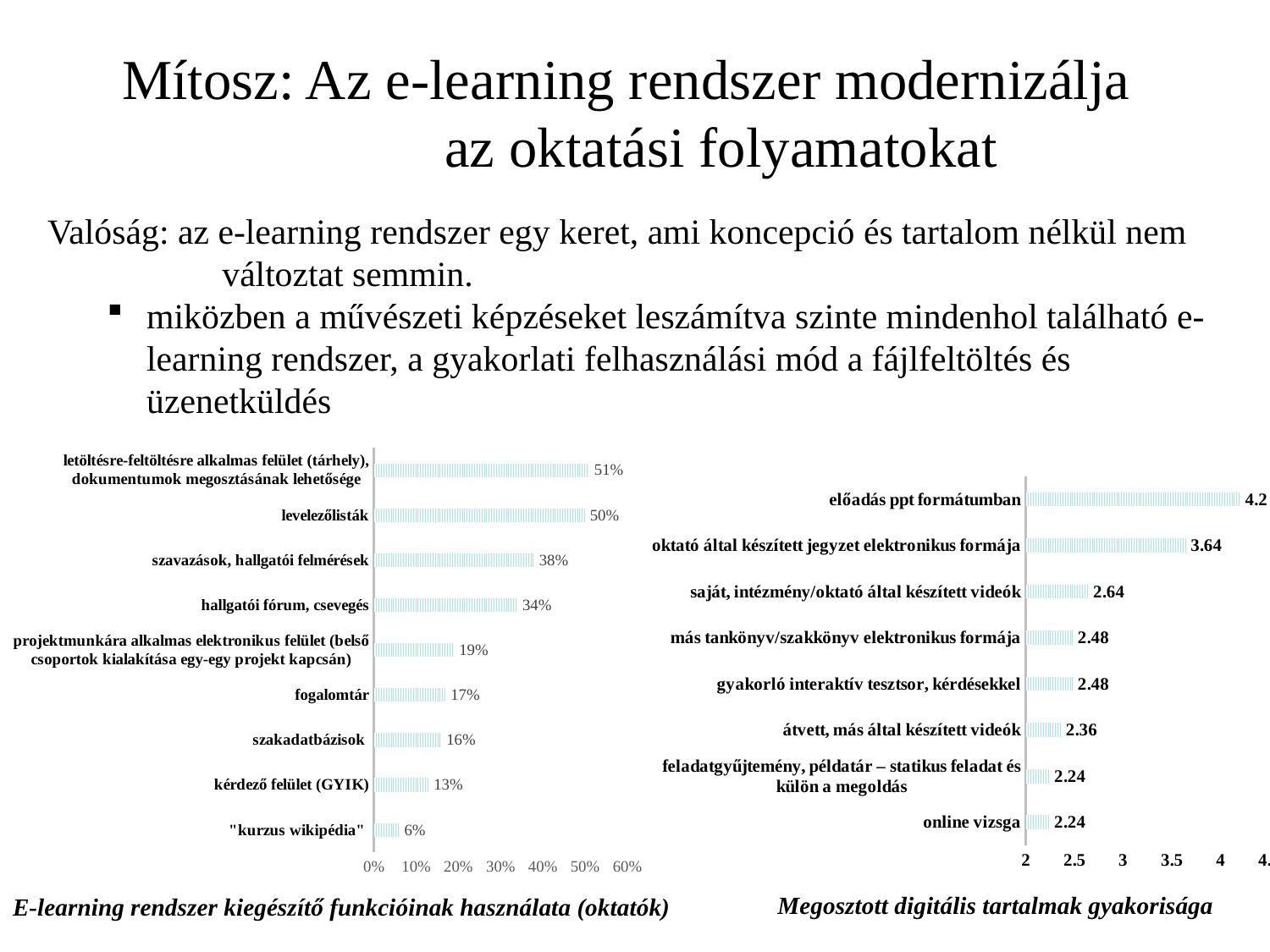
In the right chart (Megosztott digitális tartalmak gyakorisága), what is the value for "átvett, más által készített videók"? 2.36 In the right chart (Megosztott digitális tartalmak gyakorisága), what is the value for "előadás ppt formátumban"? 4.2 In the left chart (E-learning rendszer kiegészítő funkcióinak használata), what is the value for "szakadatbázisok"? 16% What type of chart is the right chart (Megosztott digitális tartalmak gyakorisága)? bar chart In the left chart (E-learning rendszer kiegészítő funkcióinak használata), how many categories are shown? 9 In the left chart (E-learning rendszer kiegészítő funkcióinak használata), which is larger: "fogalomtár" or "kérdező felület (GYIK)"? fogalomtár In the left chart (E-learning rendszer kiegészítő funkcióinak használata), which category has the lowest value? "kurzus wikipédia" In the right chart (Megosztott digitális tartalmak gyakorisága), what is the difference between "oktató által készített jegyzet elektronikus formája" and "saját, intézmény/oktató által készített videók"? 1 In the right chart (Megosztott digitális tartalmak gyakorisága), which category has the highest value? előadás ppt formátumban In the right chart (Megosztott digitális tartalmak gyakorisága), how many categories are shown? 8 In the left chart (E-learning rendszer kiegészítő funkcióinak használata), what is the difference between "szavazások, hallgatói felmérések" and "hallgatói fórum, csevegés"? 4% In the left chart (E-learning rendszer kiegészítő funkcióinak használata), what is the value for "levelezőlisták"? 50%